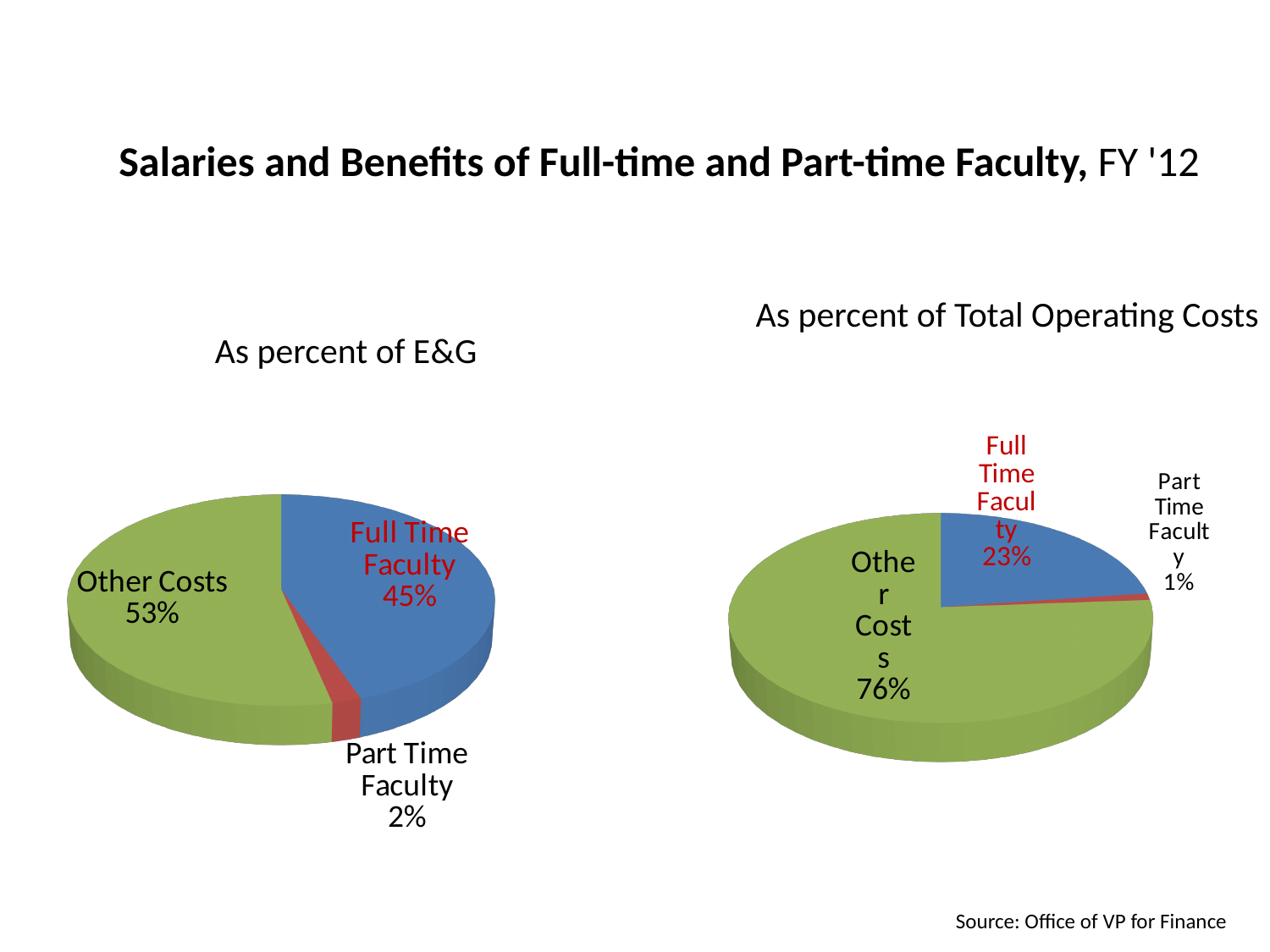
What type of chart is the 'As percent of E&G' chart? Pie chart In the 'As percent of E&G' chart, what share is Other Costs? 53% What is the title of the slide? Salaries and Benefits of Full-time and Part-time Faculty, FY '12 In the 'As percent of E&G' chart, which category has the largest slice? Other Costs How many slices does the 'As percent of Total Operating Costs' chart have? 3 In the 'As percent of Total Operating Costs' chart, what is the difference between Other Costs and Full Time Faculty? 53% In the 'As percent of Total Operating Costs' chart, what share is Full Time Faculty? 23% In the 'As percent of E&G' chart, what share is Full Time Faculty? 45% In the 'As percent of E&G' chart, which is larger, Full Time Faculty or Part Time Faculty? Full Time Faculty In the 'As percent of Total Operating Costs' chart, which category has the smallest slice? Part Time Faculty In the 'As percent of E&G' chart, what is the difference between Other Costs and Full Time Faculty? 8% In the 'As percent of Total Operating Costs' chart, what share is Part Time Faculty? 1%